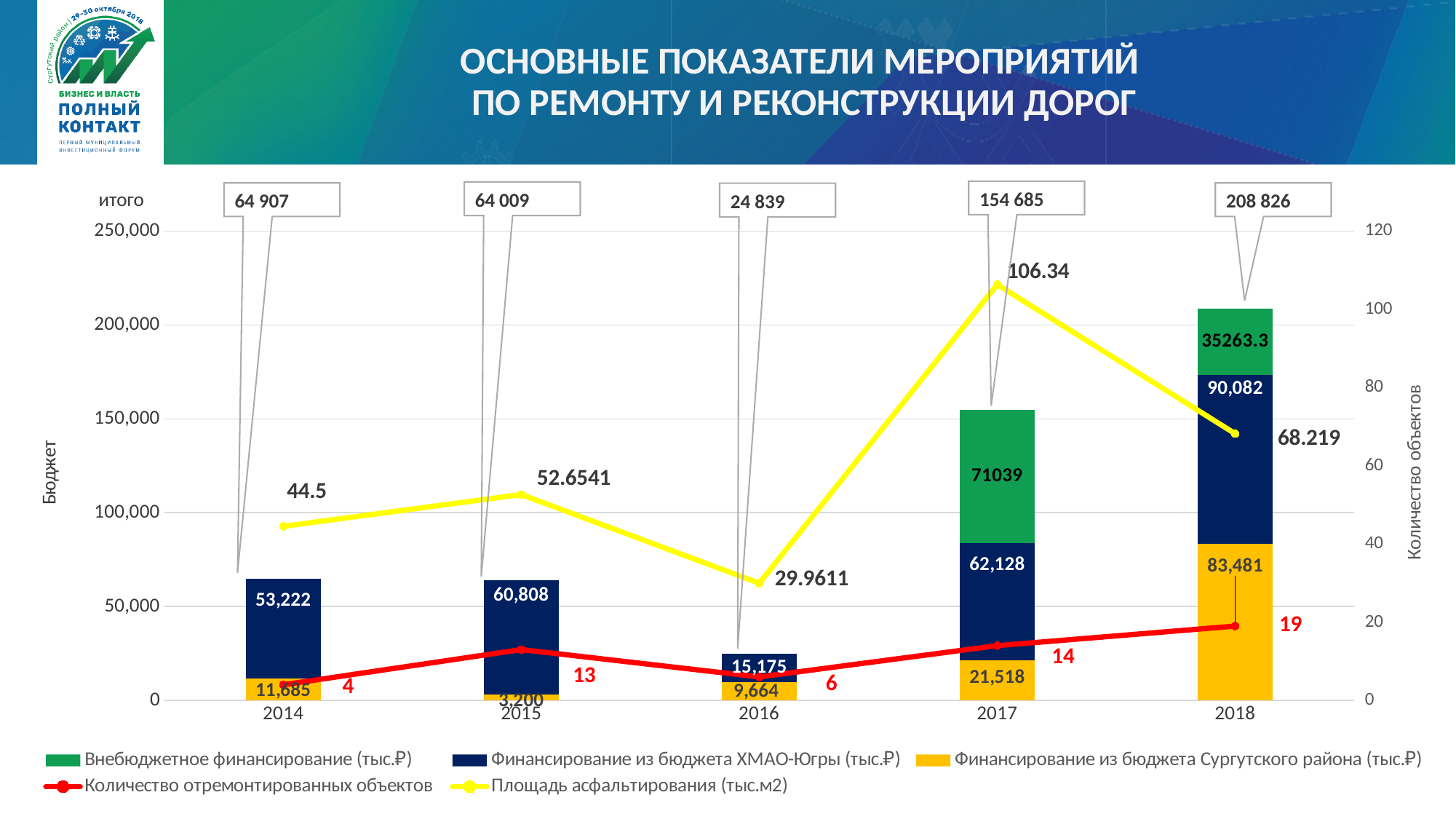
How many repaired objects (Количество отремонтированных объектов) are shown for 2015? 13 In which year is the Площадь асфальтирования line at its highest? 2017 What is the Внебюджетное финансирование (тыс.₽) value for 2017? 71039 In which year is the Количество отремонтированных объектов value the lowest? 2014 How many years are shown on the x axis of the chart? 5 What is the value of Финансирование из бюджета ХМАО-Югры (тыс.₽) for 2018? 90,082 What is the Площадь асфальтирования (тыс.м2) value for 2017? 106.34 What is the value of Финансирование из бюджета Сургутского района (тыс.₽) for 2017? 21,518 What is the total (итого) shown for the 2018 bar? 208 826 How many series does the legend list? 5 What is the difference between the Финансирование из бюджета ХМАО-Югры values for 2015 and 2014? 7,586 For 2018, which is larger: Финансирование из бюджета ХМАО-Югры or Финансирование из бюджета Сургутского района? Финансирование из бюджета ХМАО-Югры